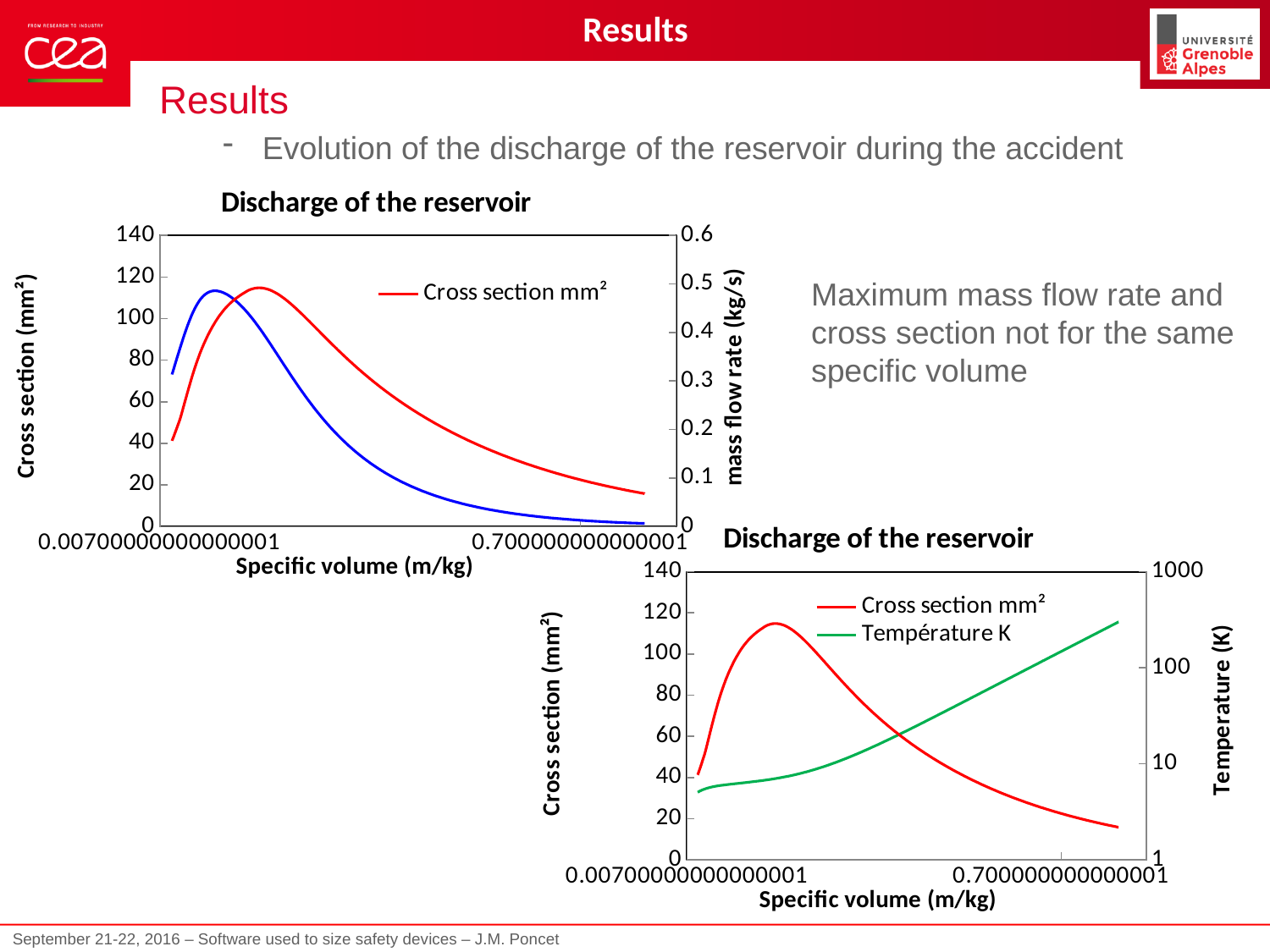
In the top-left chart, how many series does the legend list? 1 What kind of chart is the bottom-right 'Discharge of the reservoir' chart? line chart In the bottom-right chart, is the Température K value at the left end of the x axis greater or less than 10? less In the bottom-right chart, does the Température K series rise or fall as specific volume increases? rise In the top-left chart, does the Cross section mm² series rise or fall after its peak as specific volume increases? fall What kind of chart is the top-left 'Discharge of the reservoir' chart? line chart In the bottom-right chart, which series is drawn in green? Température K In the bottom-right chart, is the Température K value at the right end of the x axis greater or less than 100? greater In the bottom-right chart, is the Cross section mm² value at the right end of the x axis greater or less than 20? less In the top-left chart, what is the label of the right-hand vertical axis? mass flow rate (kg/s) In the bottom-right chart, how many series does the legend list? 2